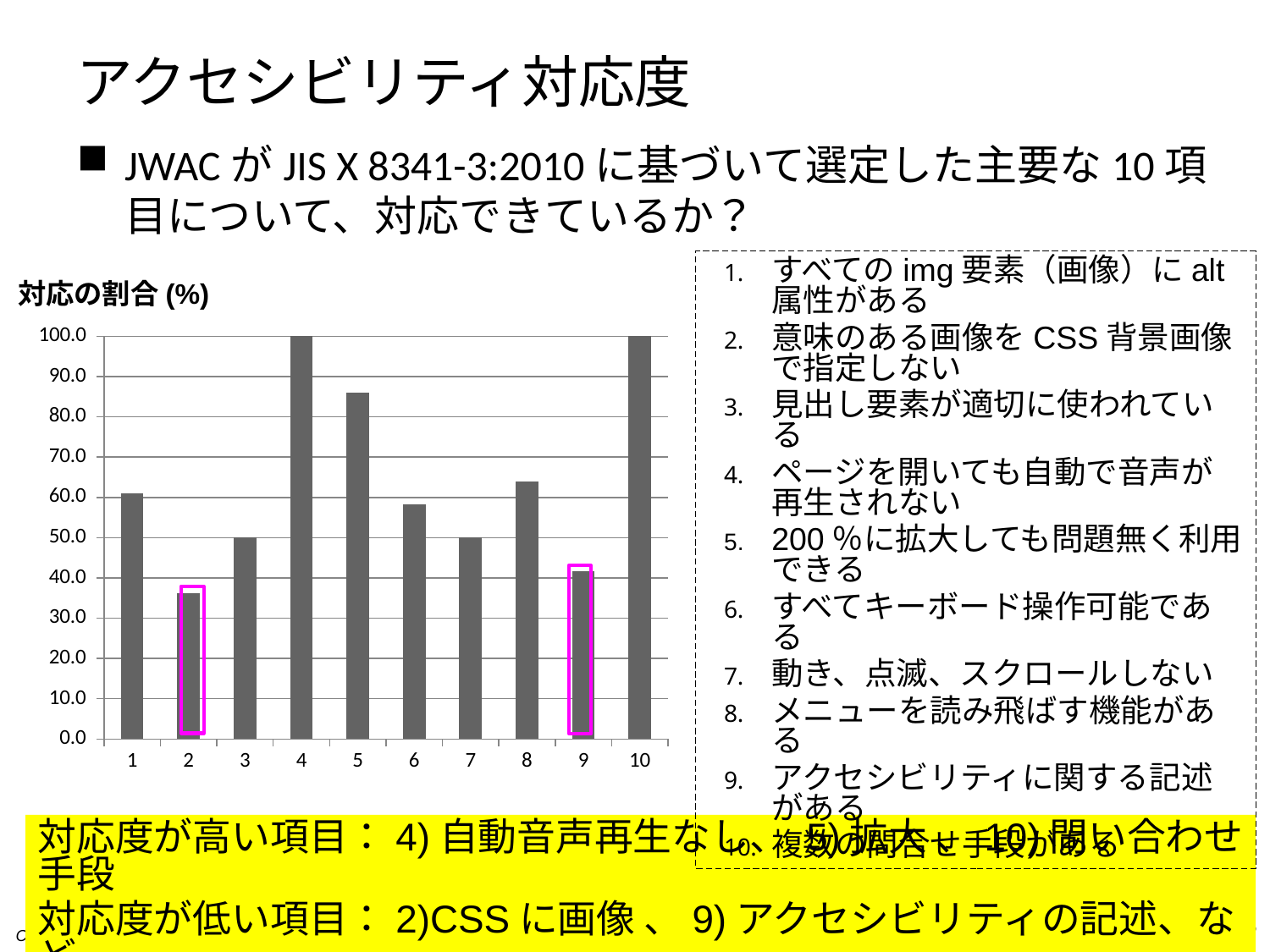
Is the value for category 9 greater or less than 50? less What is the value for category 10? 100.0 Is the value for category 1 greater or less than 50? greater What is the value for category 4? 100.0 What kind of chart is shown on the slide? bar chart Which has the larger value, category 6 or category 9? 6 What is the title shown above the chart? 対応の割合 (%) Which has the larger value, category 5 or category 8? 5 Is the value for category 2 greater or less than 40? less Which category has the lowest value? 2 How many categories are plotted on the x axis of the chart? 10